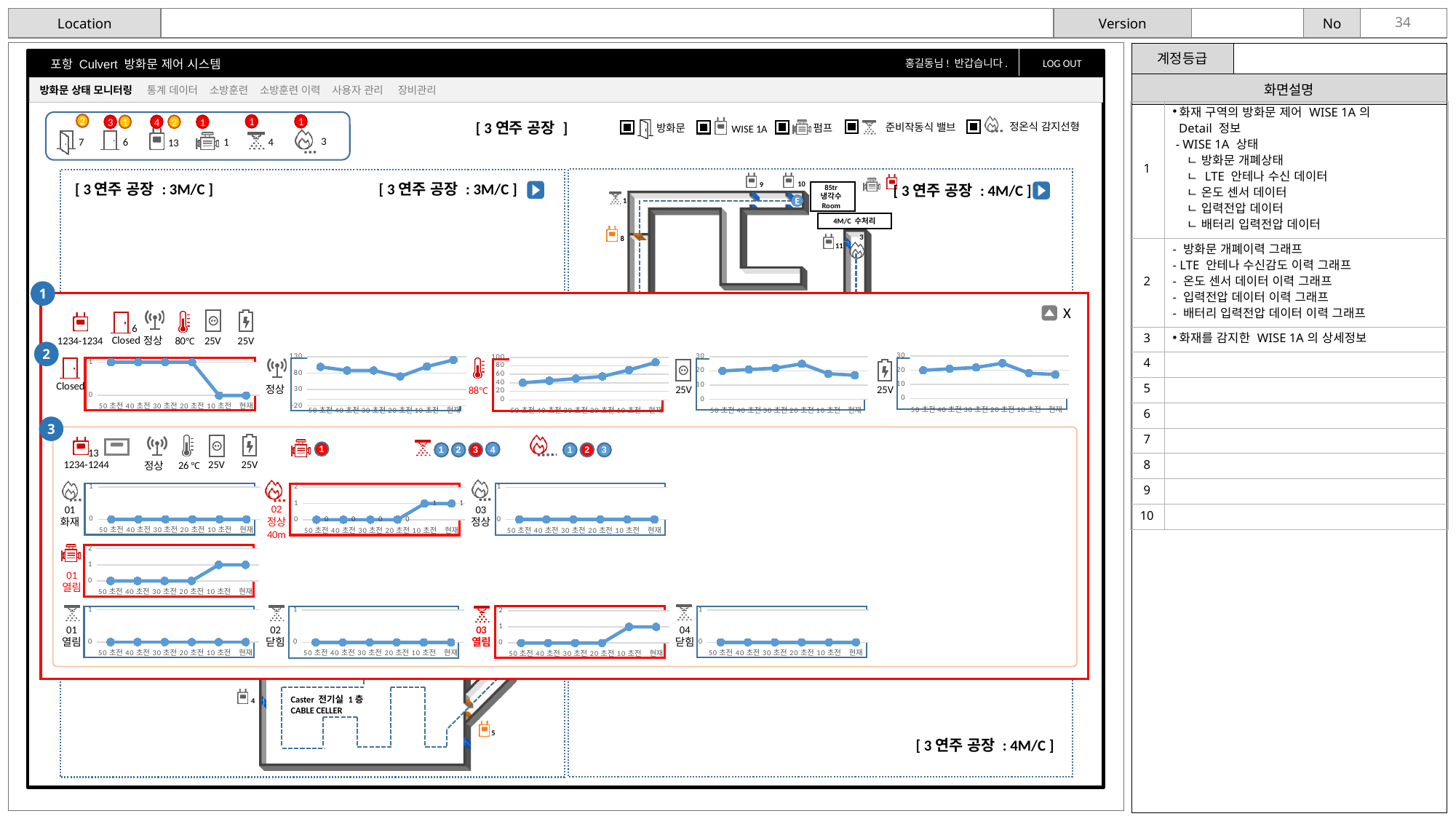
How many time points are plotted along the x axis of the Closed chart in section 2? 6 In the Closed chart in section 2, what is the value at 현재? 0 In the chart labelled 02 정상 40m in section 3, what is the difference between the value at 현재 and the value at 30 초전? 1 How many small line charts are shown in section 3 (the orange-bordered area)? 8 In the chart labelled 02 정상 40m in section 3, what is the value at 30 초전? 0 What kind of chart is the temperature chart labelled 88℃ in section 2? line chart In the temperature chart labelled 88℃ in section 2, is the value at 현재 greater or less than 80? greater In the chart labelled 02 정상 40m in section 3, what is the value at 현재? 1 Do the values in the temperature chart labelled 88℃ in section 2 rise or fall from 50 초전 to 현재? rise In the chart labelled 02 정상 40m in section 3, which is larger, the value at 10 초전 or the value at 40 초전? 10 초전 In the LTE chart labelled 정상 in section 2, is the value at 현재 greater or less than 80? greater In the Closed chart in section 2, what is the value at 50 초전? 1